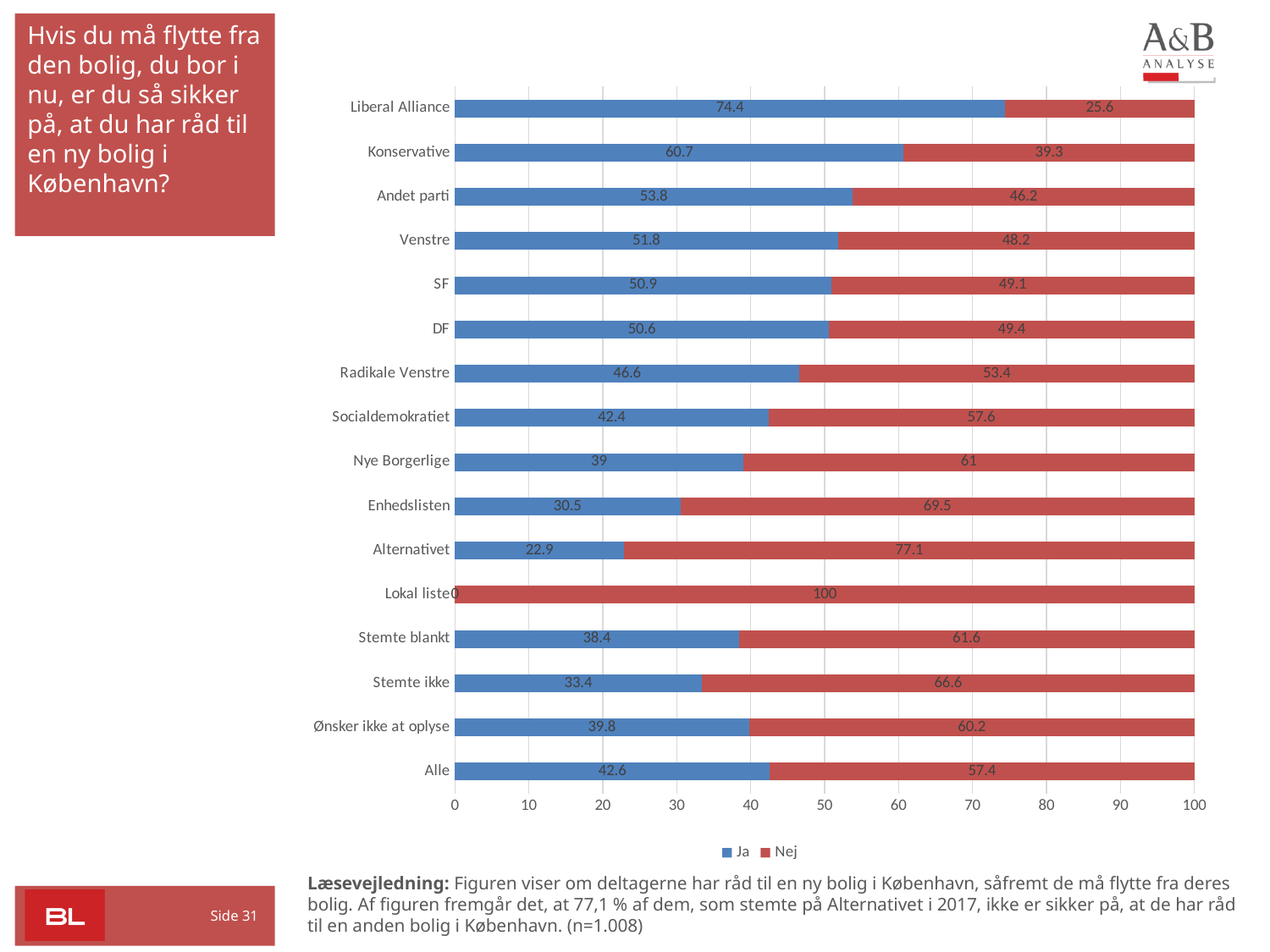
What is the Ja value for Liberal Alliance? 74.4 What is the difference between the Nej and Ja values for Enhedslisten? 39 What is the total of the stacked bar for Socialdemokratiet? 100 Which category has the highest Ja value? Liberal Alliance How many categories are shown on the chart? 16 What is the difference between the Ja values for Liberal Alliance and Konservative? 13.7 What is the Ja value for Alle? 42.6 Which has a larger Ja value, Konservative or Venstre? Konservative What kind of chart is shown on the slide? Stacked bar chart How many series does the legend list? 2 What is the Nej value for Alternativet? 77.1 Which category has the lowest Ja value? Lokal liste